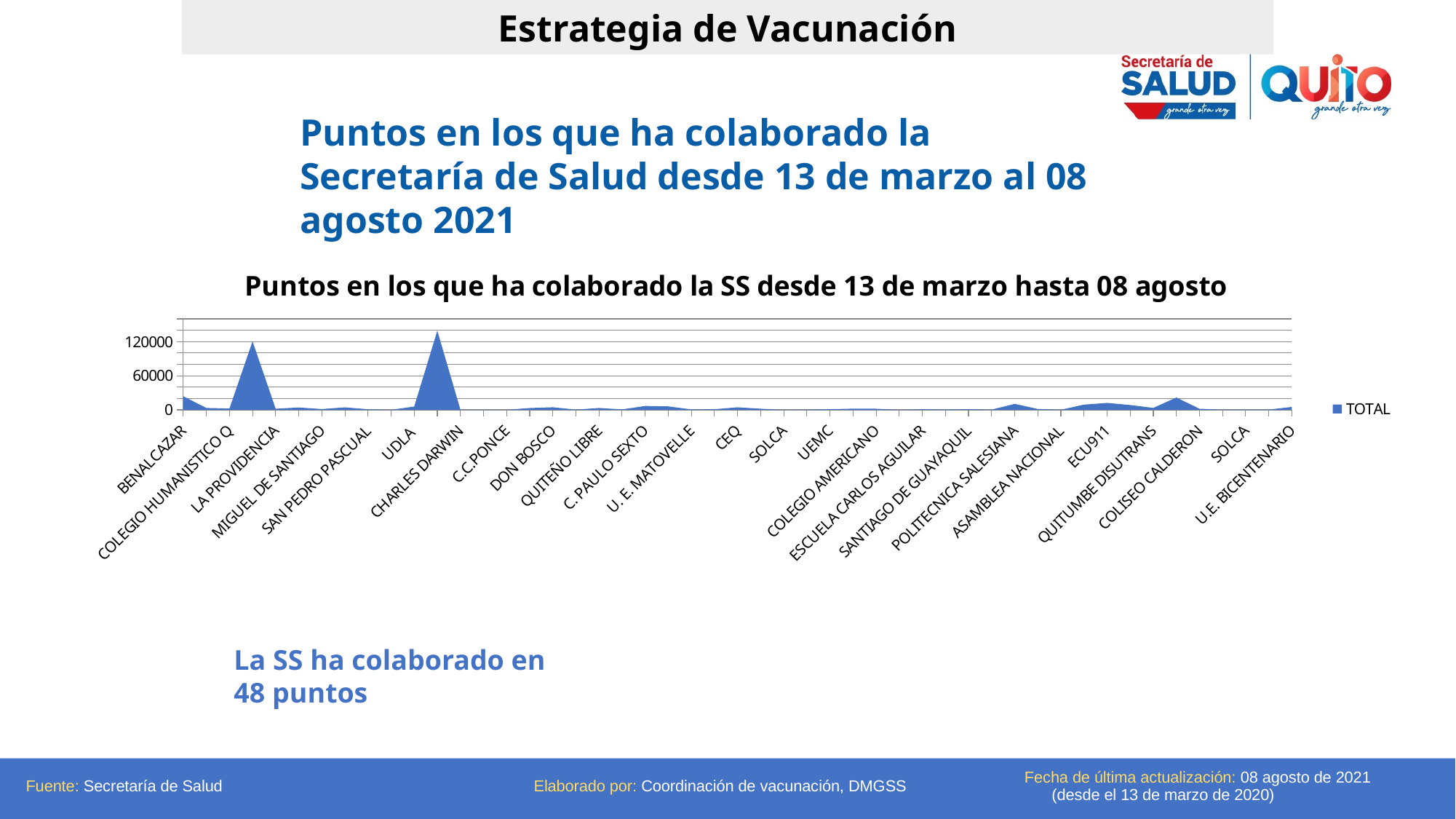
Is the value for COLISEO CALDERON greater or less than 60000? less What is the title of the chart? Puntos en los que ha colaborado la SS desde 13 de marzo hasta 08 agosto What is the name of the series shown in the chart legend? TOTAL What kind of chart is shown on the slide? Area chart Is the value for BENALCAZAR greater or less than 60000? less How many series does the chart legend list? 1